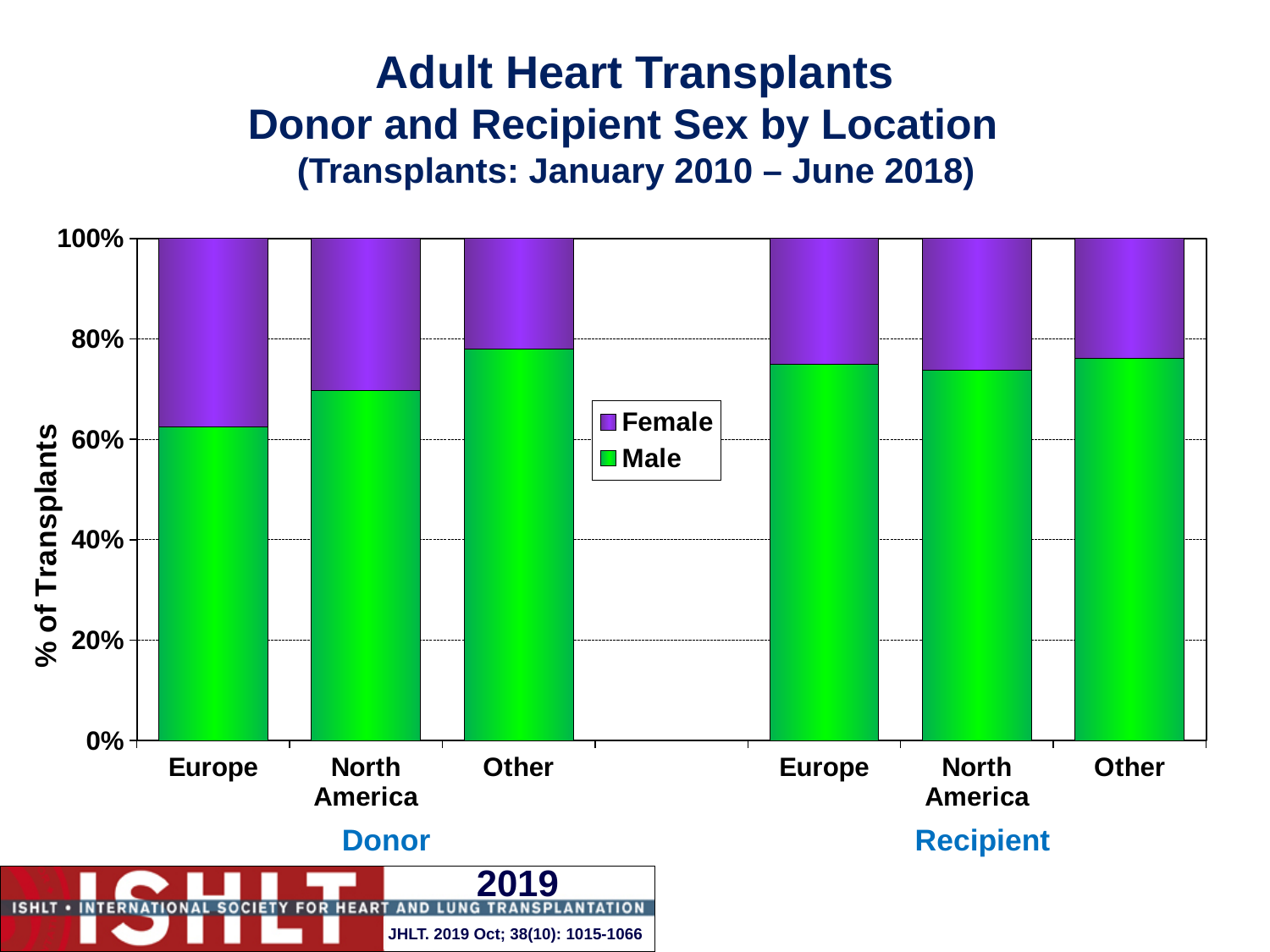
Which series is shown in green? Male How many series does the legend list? 2 Is the Female share for Donor Europe greater or less than 20%? greater What is the label on the y axis? % of Transplants Is the Male share for Donor Other greater or less than 80%? less Which is larger, the Female share for Donor Europe or the Female share for Recipient Europe? Donor Europe Is the Male share for Donor Europe greater or less than 60%? greater Among the three Donor locations, which has the lowest Male share? Europe How many bars are plotted in the chart? 6 What kind of chart is shown on the slide? Stacked bar chart Among the three Donor locations, which has the highest Male share? Other